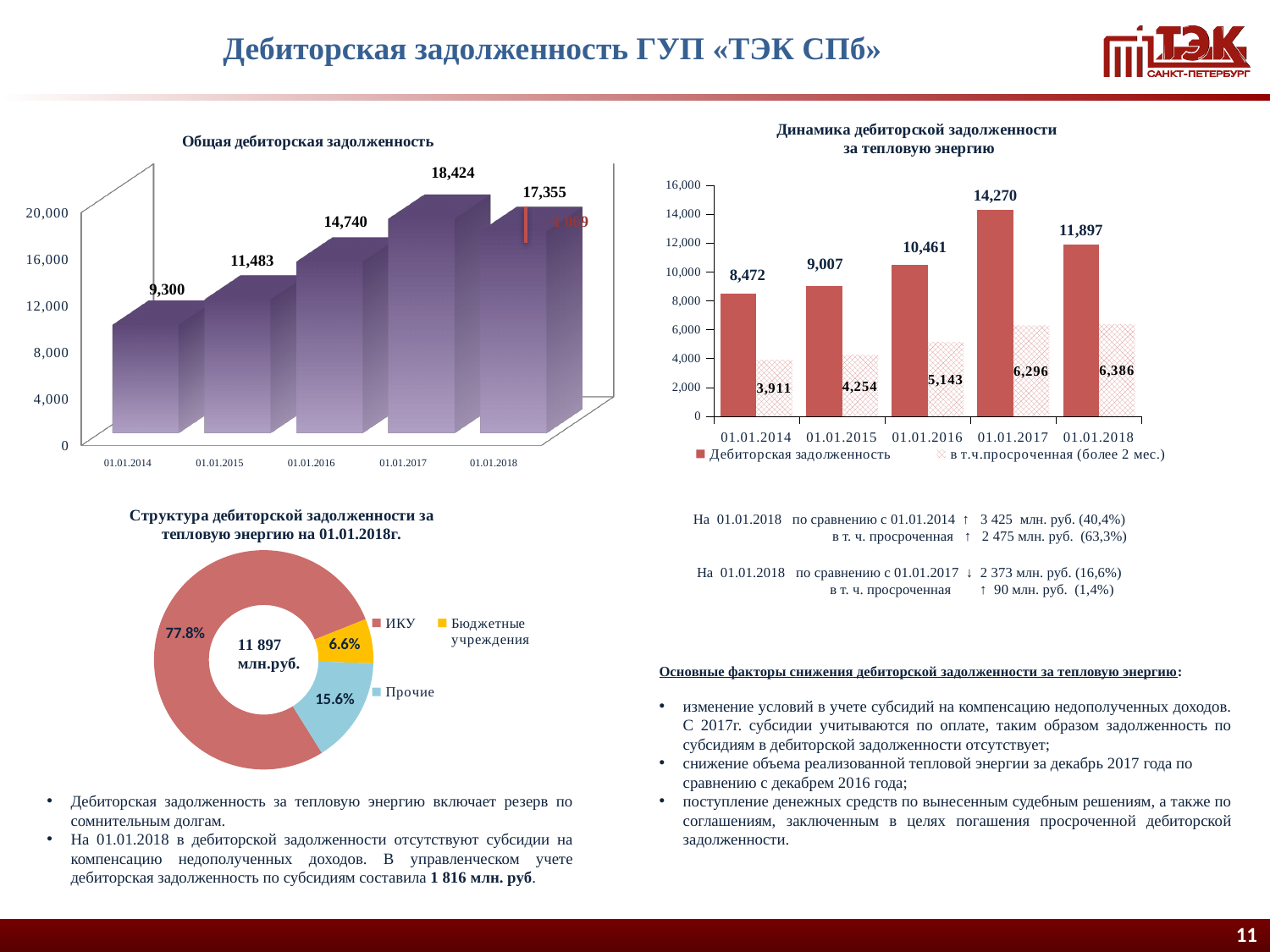
In the chart 'Динамика дебиторской задолженности за тепловую энергию', what is the value of 'в т.ч.просроченная (более 2 мес.)' for 01.01.2018? 6,386 In the chart 'Структура дебиторской задолженности за тепловую энергию на 01.01.2018г.', which category has the largest share? ИКУ In the chart 'Общая дебиторская задолженность', how many dates are plotted? 5 In the chart 'Общая дебиторская задолженность', what is the difference between the values for 01.01.2017 and 01.01.2018? 1,069 In the chart 'Общая дебиторская задолженность', which date has the lowest value? 01.01.2014 In the chart 'Динамика дебиторской задолженности за тепловую энергию', what is the value of 'Дебиторская задолженность' for 01.01.2016? 10,461 In the chart 'Общая дебиторская задолженность', what is the value for 01.01.2017? 18,424 In the chart 'Динамика дебиторской задолженности за тепловую энергию', how many series does the legend list? 2 In the chart 'Структура дебиторской задолженности за тепловую энергию на 01.01.2018г.', what share does 'Прочие' have? 15.6% In the chart 'Динамика дебиторской задолженности за тепловую энергию', what is the difference between 'Дебиторская задолженность' for 01.01.2017 and 01.01.2014? 5,798 In the chart 'Динамика дебиторской задолженности за тепловую энергию', which date has the highest 'Дебиторская задолженность'? 01.01.2017 What kind of chart is 'Структура дебиторской задолженности за тепловую энергию на 01.01.2018г.'? Doughnut chart